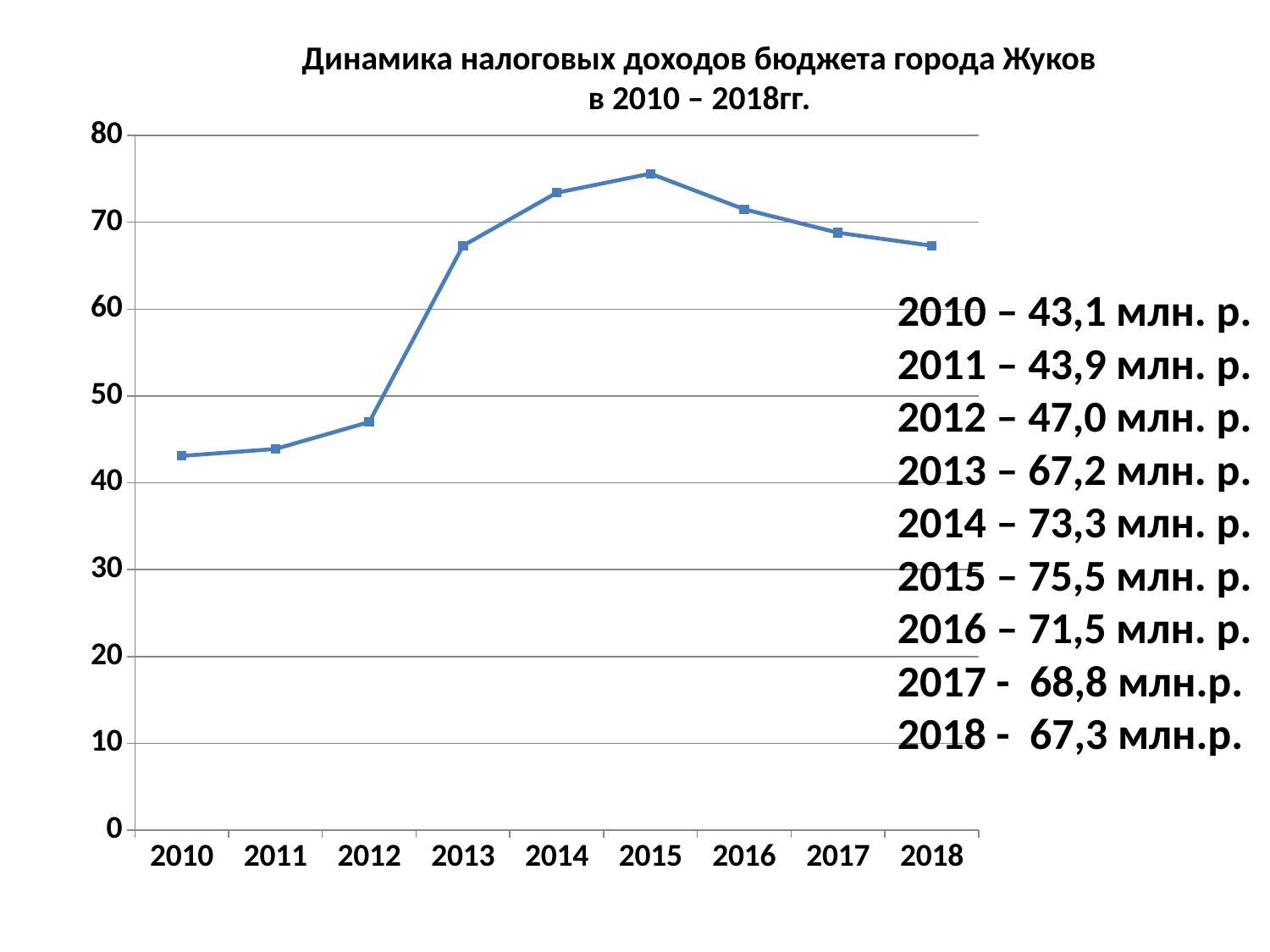
Which year has the lowest value? 2010 What type of chart is shown on the slide? line chart What is the value for 2018? 67,3 млн.р. Do the values rise or fall from 2015 to 2018? fall What is the difference between the values for 2013 and 2012? 20,2 млн. р. Is the value for 2012 greater or less than 50? less What is the value for 2010? 43,1 млн. р. What is the title of the chart? Динамика налоговых доходов бюджета города Жуков в 2010 – 2018гг. Which year has the highest value? 2015 Which is larger, the value for 2014 or the value for 2016? 2014 What is the value for 2015? 75,5 млн. р. How many years are plotted on the x axis? 9